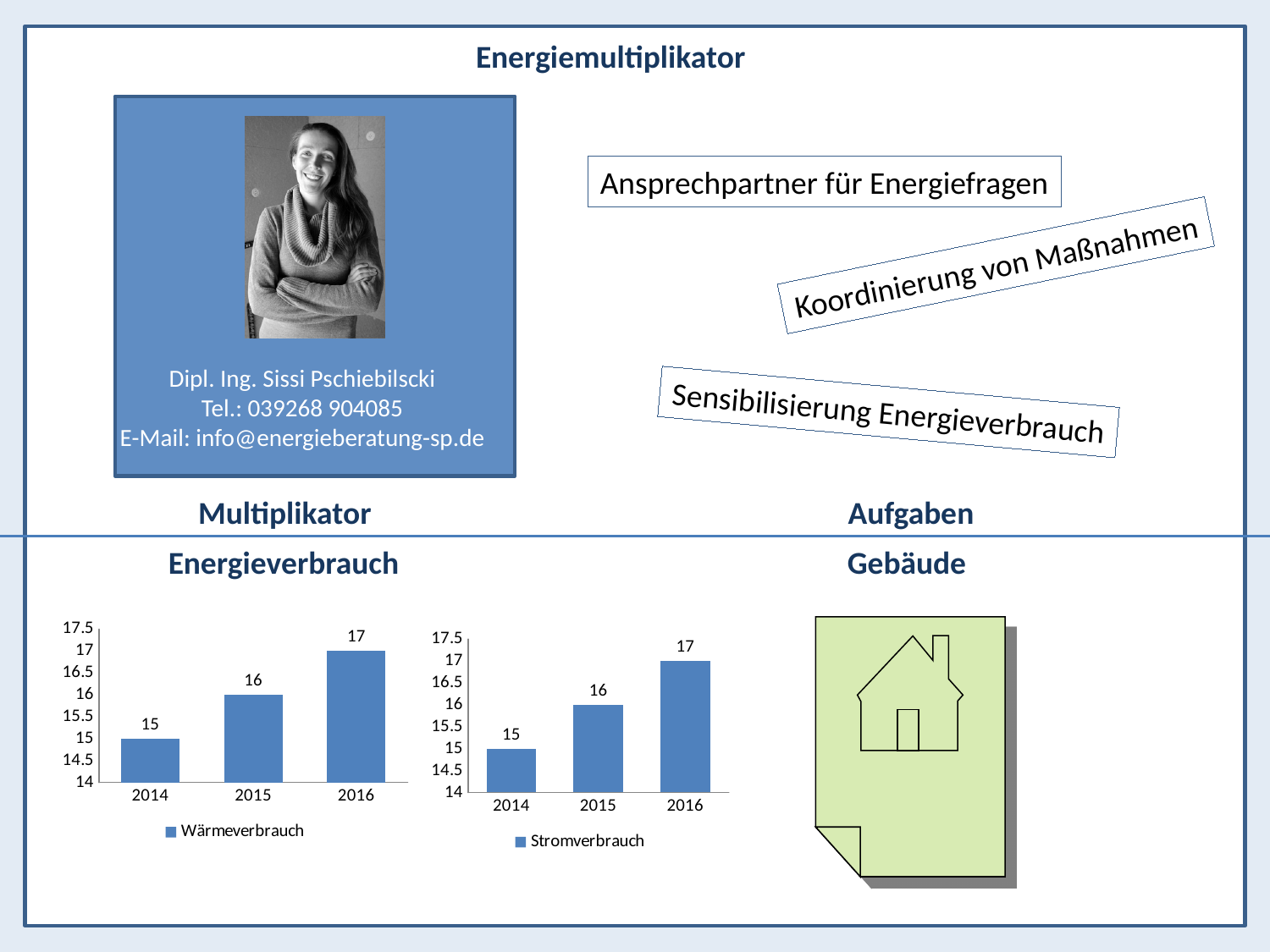
In the Stromverbrauch chart (right), do the values rise or fall from 2014 to 2016? rise In the Stromverbrauch chart (right), which year has the lowest value? 2014 In the Stromverbrauch chart (right), what is the difference between the values for 2015 and 2014? 1 In the Wärmeverbrauch chart (left), which year has the highest value? 2016 In the Wärmeverbrauch chart (left), what is the difference between the values for 2016 and 2014? 2 In the Stromverbrauch chart (right), what is the value for 2016? 17 How many series does the legend of the Stromverbrauch chart (right) list? 1 How many years are shown on the x axis of the Wärmeverbrauch chart (left)? 3 In the Wärmeverbrauch chart (left), is the value for 2016 greater or less than 16.5? greater In the Wärmeverbrauch chart (left), what is the value for 2015? 16 In the Stromverbrauch chart (right), which is larger, the value for 2014 or the value for 2016? 2016 What kind of chart is the Wärmeverbrauch chart (left)? bar chart